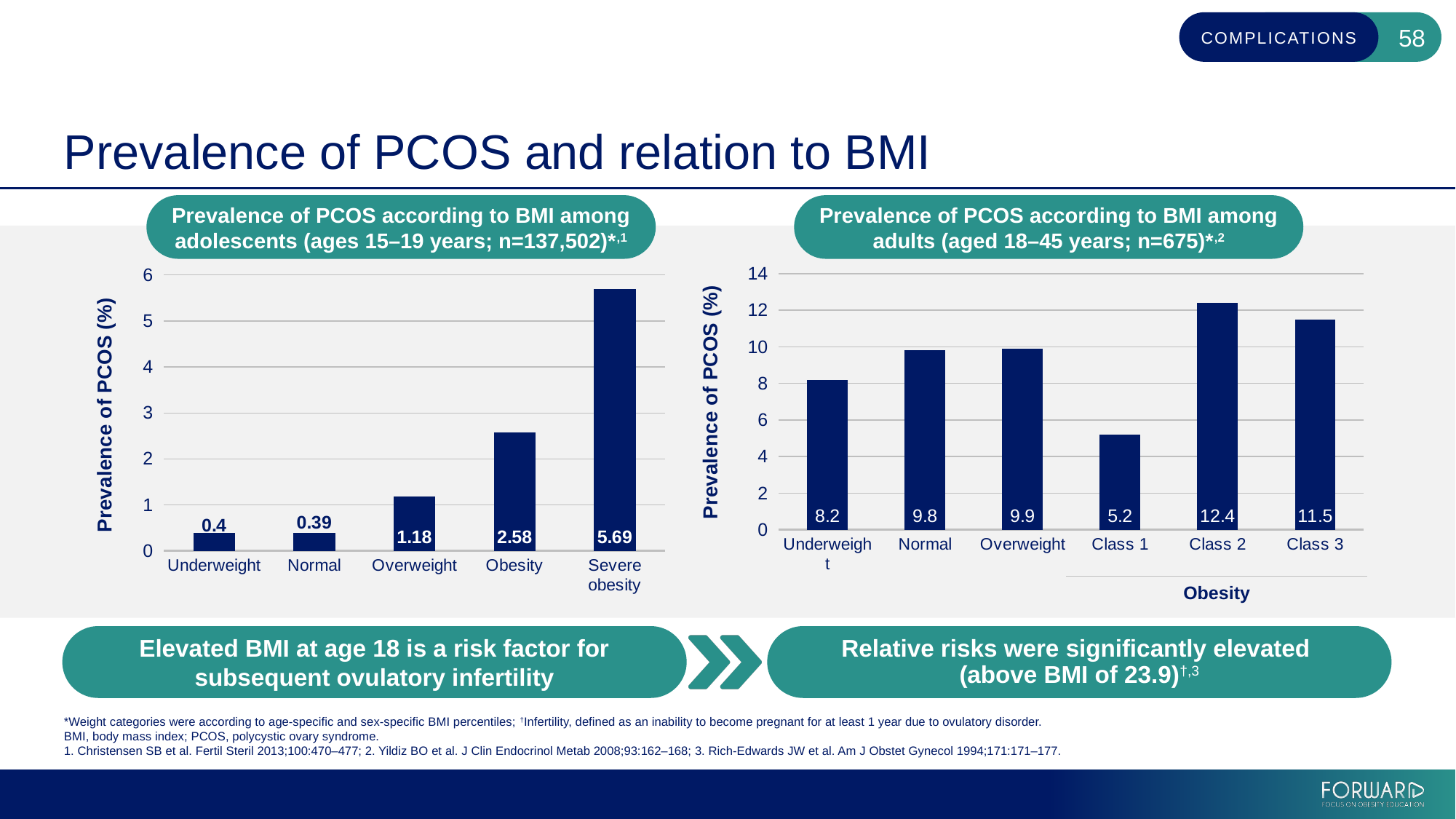
In the adolescents chart (left), is the value for Severe obesity greater or less than 5? greater What type of chart is used for the adults chart (right)? Bar chart How many BMI categories are shown in the adolescents chart (left)? 5 In the adolescents chart (left), which BMI category has the highest prevalence of PCOS? Severe obesity In the adolescents chart (left), what is the prevalence of PCOS for the Severe obesity category? 5.69 How many BMI categories are shown in the adults chart (right)? 6 What is the y-axis label of the adolescents chart (left)? Prevalence of PCOS (%) In the adults chart (right), what is the prevalence of PCOS for Class 2 obesity? 12.4 In the adults chart (right), what is the difference in PCOS prevalence between Class 2 and Class 1? 7.2 In the adolescents chart (left), what is the difference in PCOS prevalence between Obesity and Overweight? 1.4 In the adults chart (right), which category has the lowest prevalence of PCOS? Class 1 In the adults chart (right), which has a higher prevalence of PCOS: Underweight or Normal? Normal